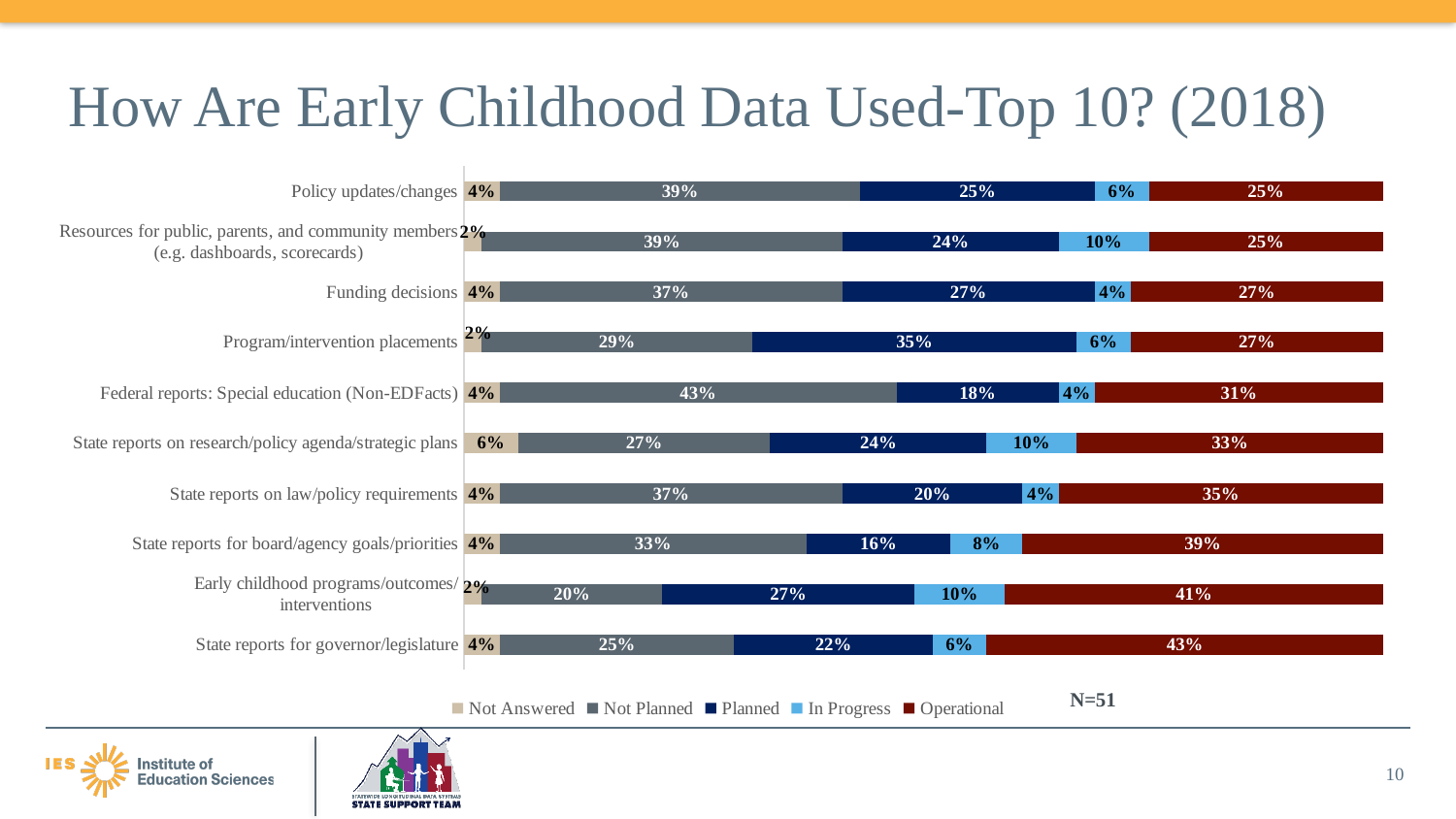
How many categories are shown in the chart? 10 Which category has the highest 'Operational' percentage? State reports for governor/legislature What is the difference between the 'Operational' values for Early childhood programs/outcomes/interventions and Policy updates/changes? 16% What is the 'In Progress' value for State reports on research/policy agenda/strategic plans? 10% What type of chart is shown on the slide? Stacked bar chart What is the 'Planned' value for Program/intervention placements? 35% What sample size (N) is shown on the slide? N=51 What is the 'Not Planned' value for Federal reports: Special education (Non-EDFacts)? 43% How many series does the legend list? 5 Which is larger: the 'Not Planned' value for Funding decisions or the 'Not Planned' value for Program/intervention placements? Funding decisions Which category has the lowest 'Planned' percentage? State reports for board/agency goals/priorities What percentage of respondents reported 'Operational' use for State reports for governor/legislature? 43%